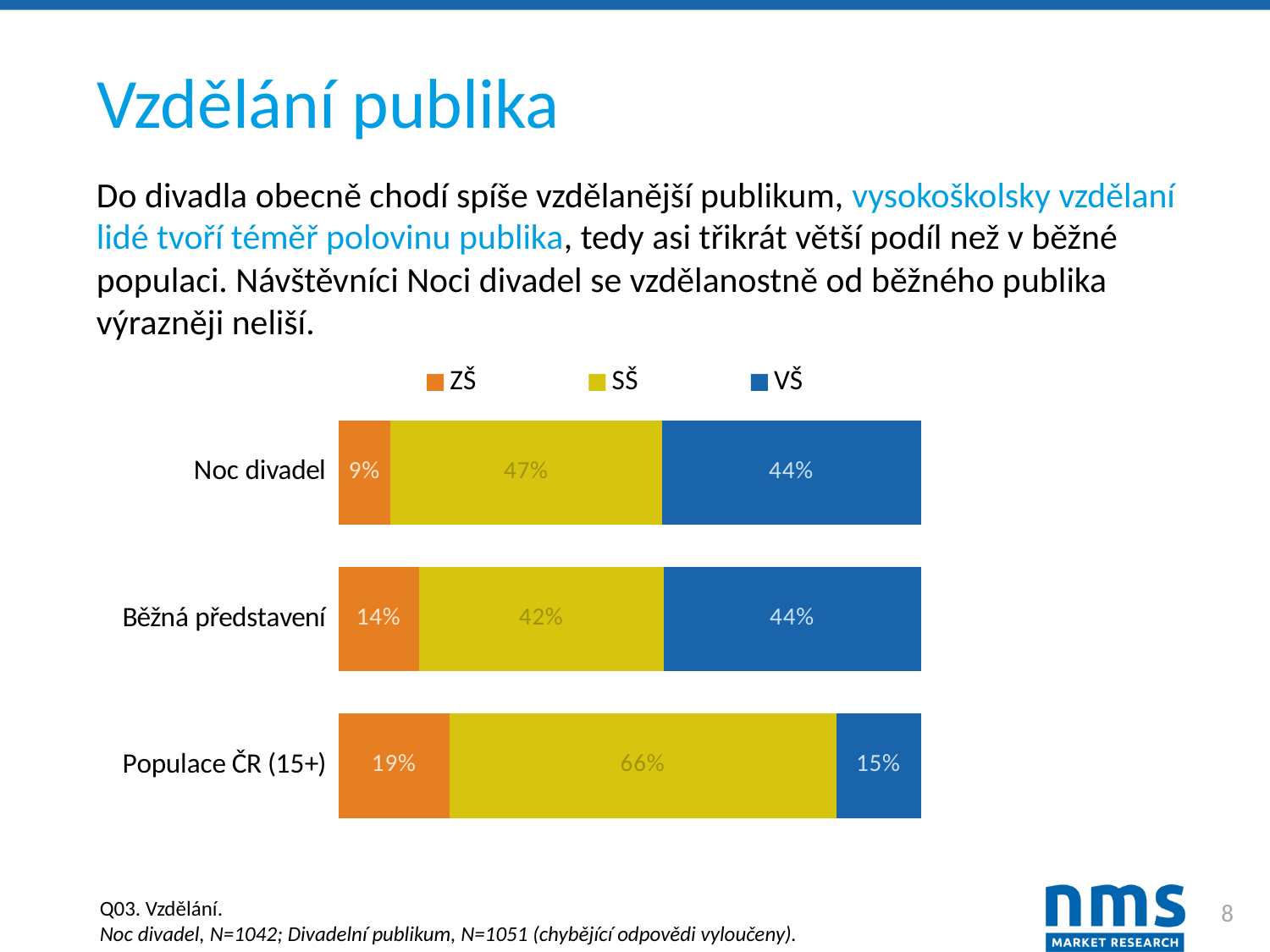
Which is larger: the ZŠ value for Noc divadel or the ZŠ value for Běžná představení? Běžná představení Which series is shown in blue in the legend? VŠ What is the ZŠ value for Běžná představení? 14% What is the total of the stacked bar for Běžná představení? 100% What is the VŠ value for Noc divadel? 44% What is the SŠ value for Populace ČR (15+)? 66% How many series does the legend list? 3 Which category has the lowest VŠ value? Populace ČR (15+) What is the difference between the SŠ value for Populace ČR (15+) and the SŠ value for Noc divadel? 19% What kind of chart is shown on the slide? Stacked bar chart Which category has the highest ZŠ value? Populace ČR (15+) How many categories are shown in the chart? 3